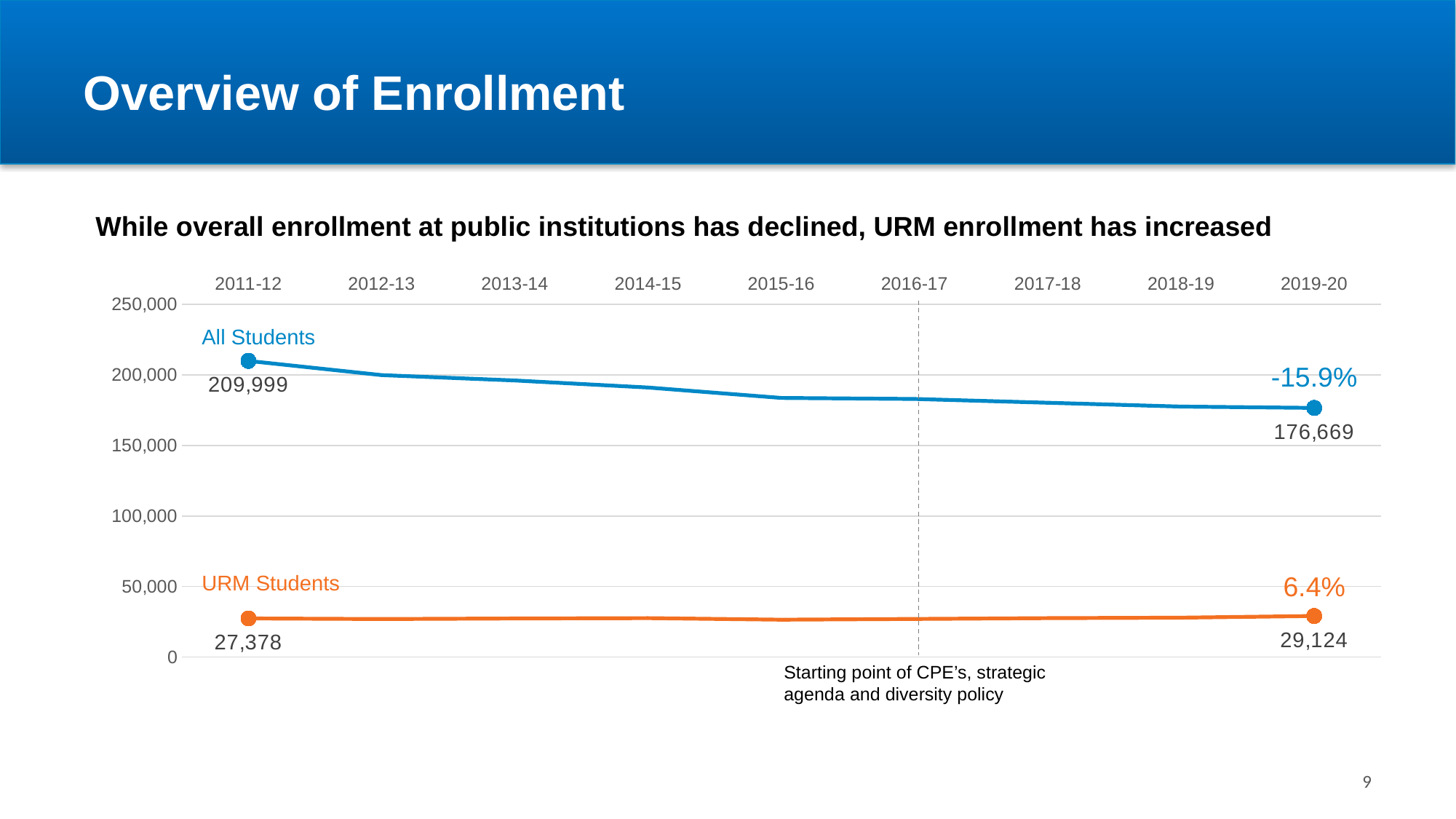
What type of chart is shown on the slide? Line chart Is the All Students value for 2016-17 greater or less than 200,000? less By how much did All Students enrollment decrease between 2011-12 and 2019-20? 33,330 Does the All Students line rise or fall from 2011-12 to 2019-20? Fall What percentage change is shown for URM Students from 2011-12 to 2019-20? 6.4% What was the URM Students enrollment in 2019-20? 29,124 By how much did URM Students enrollment increase between 2011-12 and 2019-20? 1,746 What percentage change is shown for All Students from 2011-12 to 2019-20? -15.9% What was the URM Students enrollment in 2011-12? 27,378 How many academic years are shown on the x axis? 9 What was the All Students enrollment in 2011-12? 209,999 What was the All Students enrollment in 2019-20? 176,669